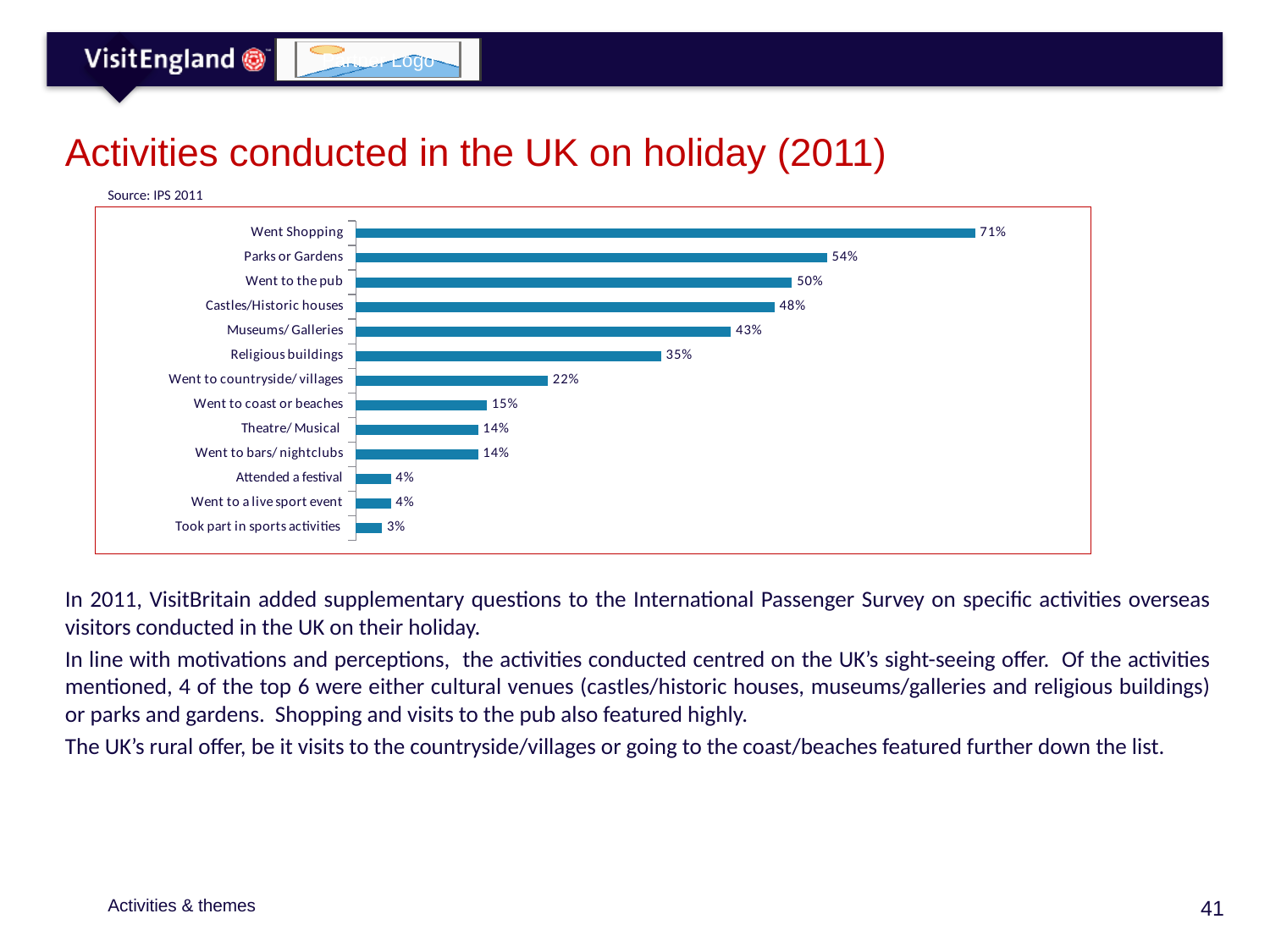
What percentage of visitors went shopping? 71% What is the difference between Went to the pub and Religious buildings? 15% Which activity has the highest value? Went Shopping Which is larger, Went to coast or beaches or Went to countryside/ villages? Went to countryside/ villages What is the difference between Went Shopping and Parks or Gardens? 17% What percentage of visitors went to countryside/ villages? 22% What is the value for Museums/ Galleries? 43% How many activities are shown in the chart? 13 What type of chart is shown on the slide? Bar chart Which is larger, Castles/Historic houses or Museums/ Galleries? Castles/Historic houses Which activity has the lowest value? Took part in sports activities What is the source cited for the chart? IPS 2011